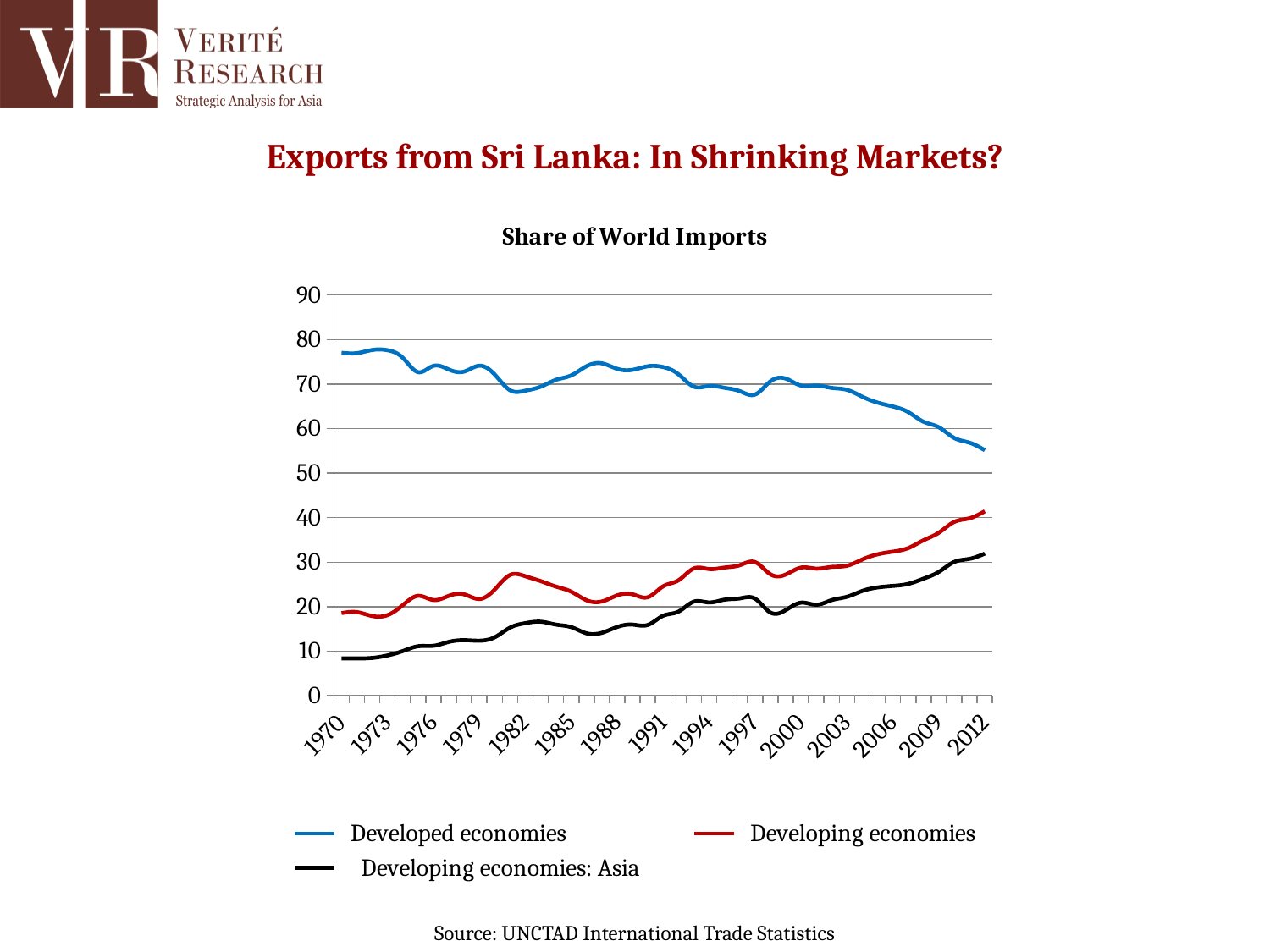
Which series has the highest share in 1970? Developed economies Does the Developed economies line rise or fall from 1970 to 2012? Fall How many series does the legend list? 3 What is the title of the chart? Share of World Imports Which series has the lowest share in 2012? Developing economies: Asia Is the value for Developing economies: Asia in 1970 greater or less than 10? less In 2012, which is larger: Developed economies or Developing economies? Developed economies Does the Developing economies line rise or fall from 1970 to 2012? Rise What kind of chart is shown on the slide? Line chart Is the value for Developed economies in 2012 greater or less than 60? less Which series is drawn in red? Developing economies Is the value for Developed economies in 1970 greater or less than 70? greater